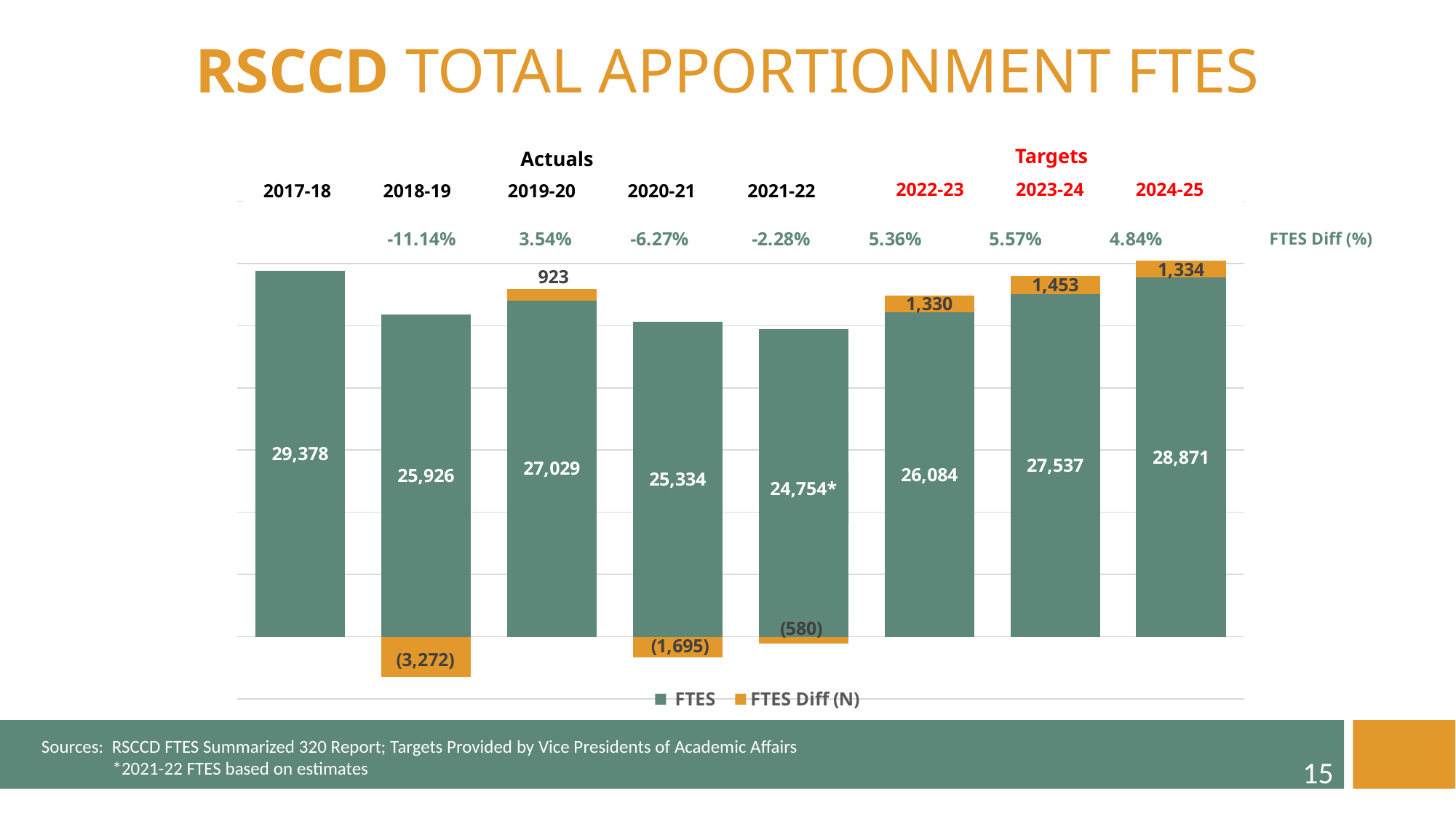
How many series does the legend list? 2 What is the FTES value for 2017-18? 29,378 Which year has the highest FTES value? 2017-18 What is the FTES Diff (%) shown for 2020-21? -6.27% Which years are labelled as Targets? 2022-23, 2023-24, 2024-25 What is the FTES Diff (N) value for 2018-19? (3,272) What is the difference between the FTES values for 2017-18 and 2018-19? 3,452 Which year has the lowest FTES value? 2021-22 What is the FTES target for 2024-25? 28,871 Which is larger, the FTES value for 2019-20 or for 2023-24? 2023-24 How many years are shown on the x axis? 8 What kind of chart is this? bar chart